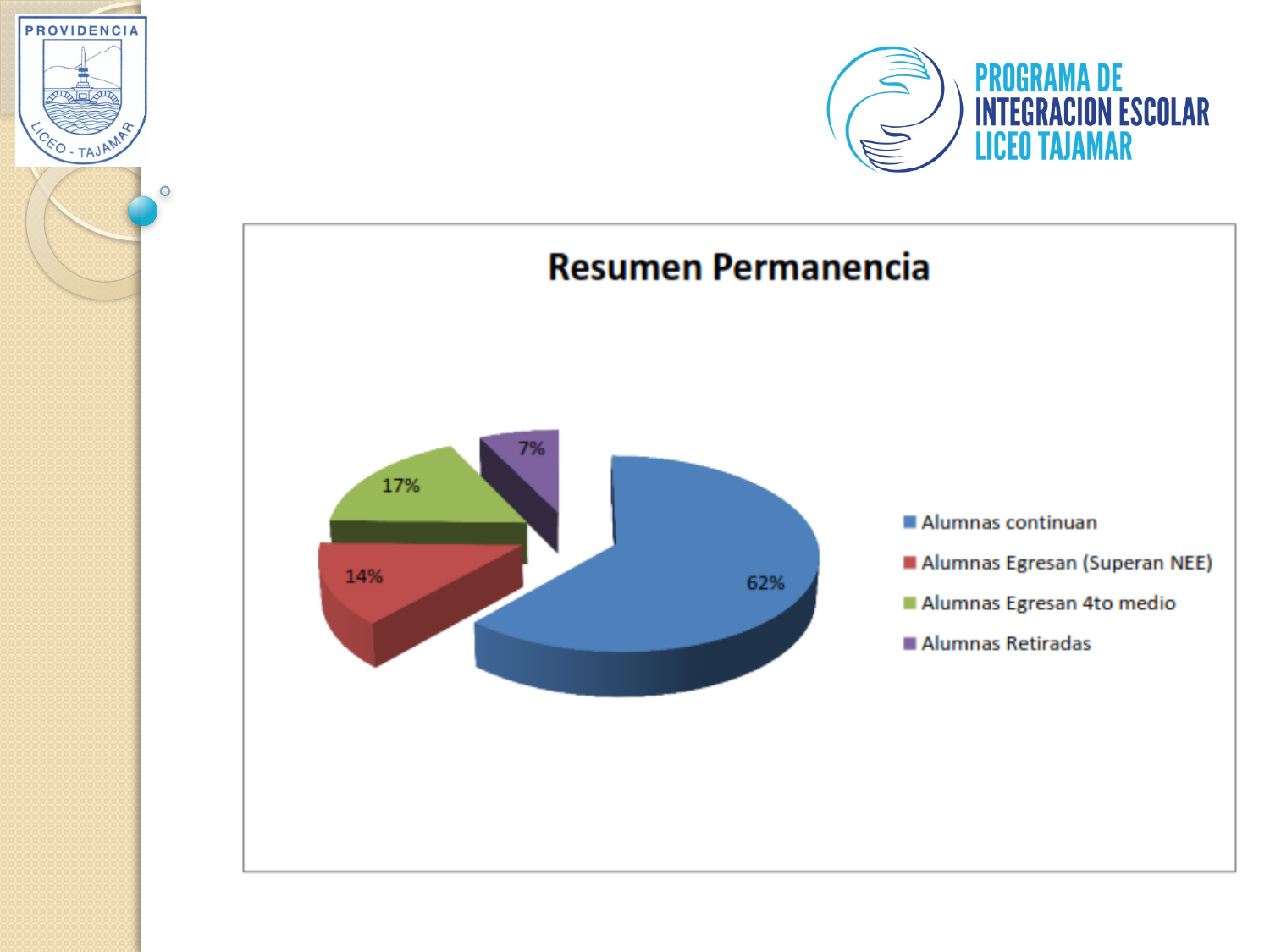
Which category has the largest slice of the pie? Alumnas continuan What colour is the slice for 'Alumnas Egresan 4to medio'? Green What is the title of the chart? Resumen Permanencia What type of chart is shown on the slide? Pie chart What percentage of the pie is 'Alumnas Egresan (Superan NEE)'? 14% How many categories does the legend list? 4 What percentage of the pie is 'Alumnas Egresan 4to medio'? 17% What is the difference in percentage points between 'Alumnas continuan' and 'Alumnas Retiradas'? 55 What percentage of the pie is 'Alumnas continuan'? 62% Which is larger: 'Alumnas Egresan 4to medio' or 'Alumnas Egresan (Superan NEE)'? Alumnas Egresan 4to medio What percentage of the pie is 'Alumnas Retiradas'? 7% Which category has the smallest slice of the pie? Alumnas Retiradas